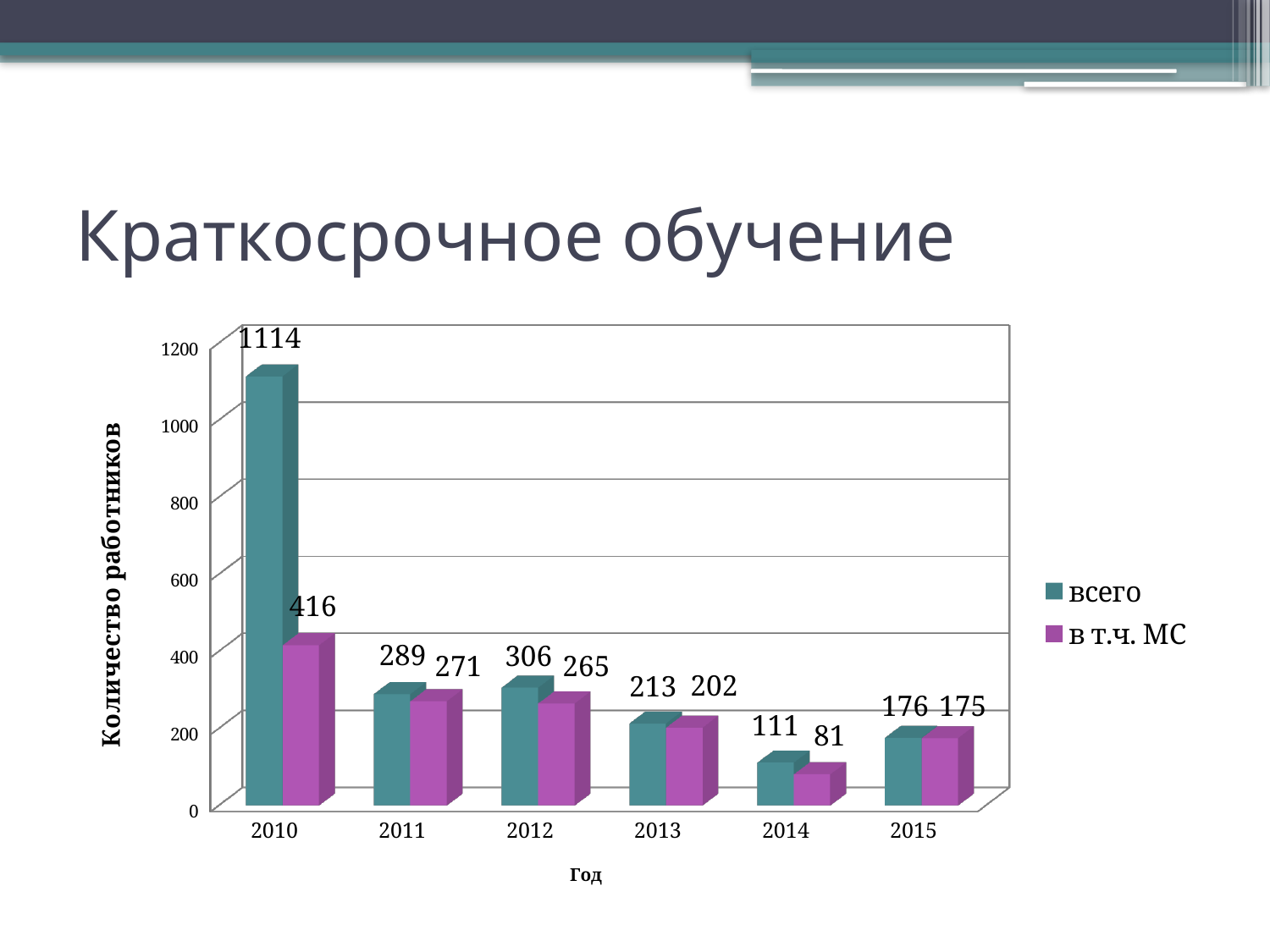
What is the value of "в т.ч. МС" for 2012? 265 Which is larger: "всего" in 2013 or "всего" in 2015? 2013 What is the difference between "всего" and "в т.ч. МС" in 2010? 698 Which year has the highest value for "всего"? 2010 What is the label of the vertical axis? Количество работников What is the difference between the "всего" values for 2012 and 2011? 17 Which year has the lowest value for "в т.ч. МС"? 2014 How many years are shown on the x axis? 6 What kind of chart is shown on the slide? bar chart What is the value of "в т.ч. МС" for 2014? 81 How many series does the legend list? 2 What is the value of "всего" for 2010? 1114